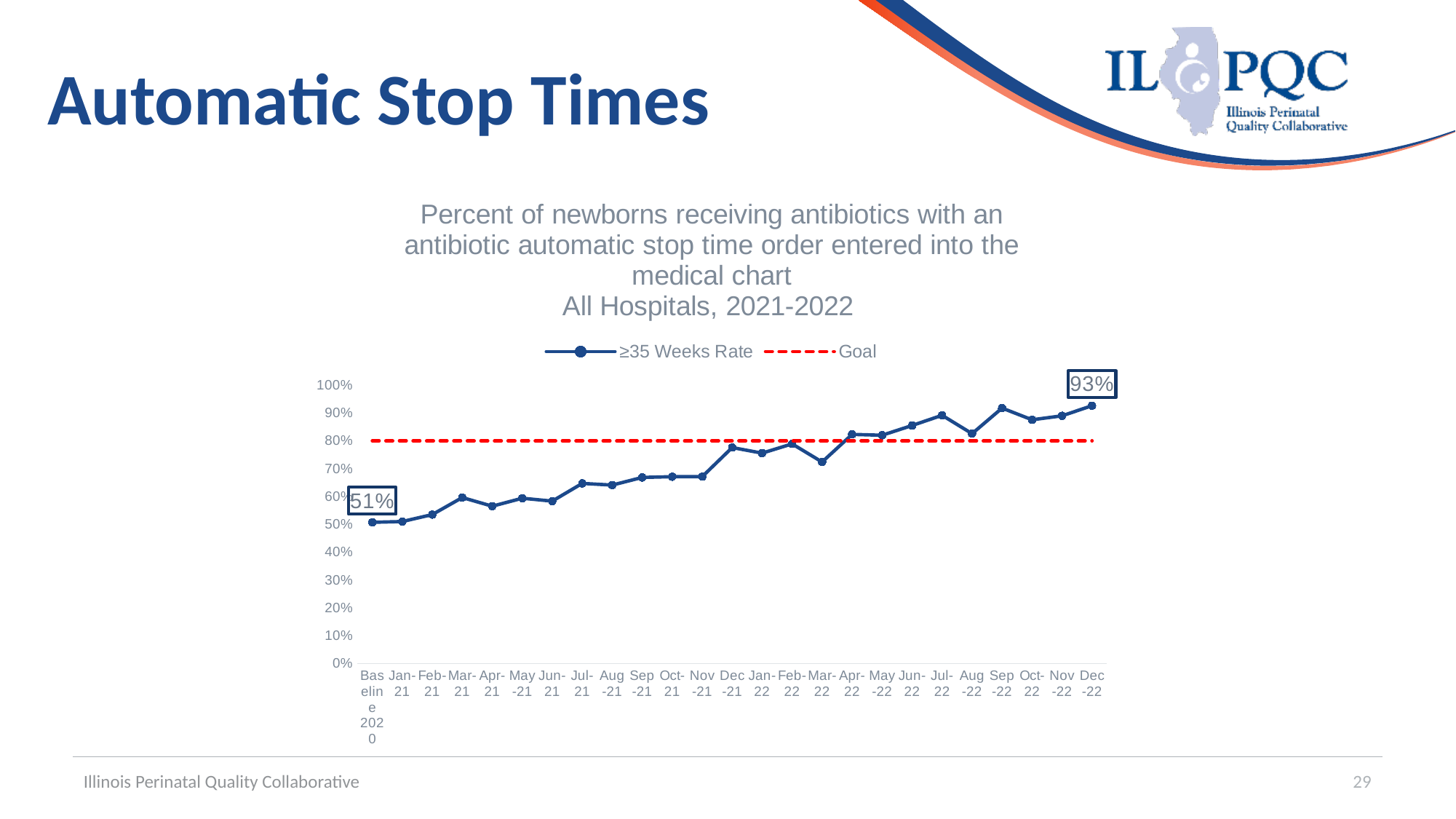
Does the ≥35 Weeks Rate generally rise or fall from Baseline 2020 to Dec-22? rise What type of chart is shown on the slide? line chart What is the ≥35 Weeks Rate value for Dec-22? 93% Which month has the highest ≥35 Weeks Rate? Dec-22 What is the difference between the Dec-22 value and the Baseline 2020 value? 42 percentage points What colour is the Goal line in the chart? red Which is larger, the value for Dec-22 or the value for Baseline 2020? Dec-22 Is the ≥35 Weeks Rate for Jan-21 greater or less than 60%? less How many series does the legend list? 2 Is the ≥35 Weeks Rate for Mar-22 greater or less than 80%? less What is the ≥35 Weeks Rate value for Baseline 2020? 51%